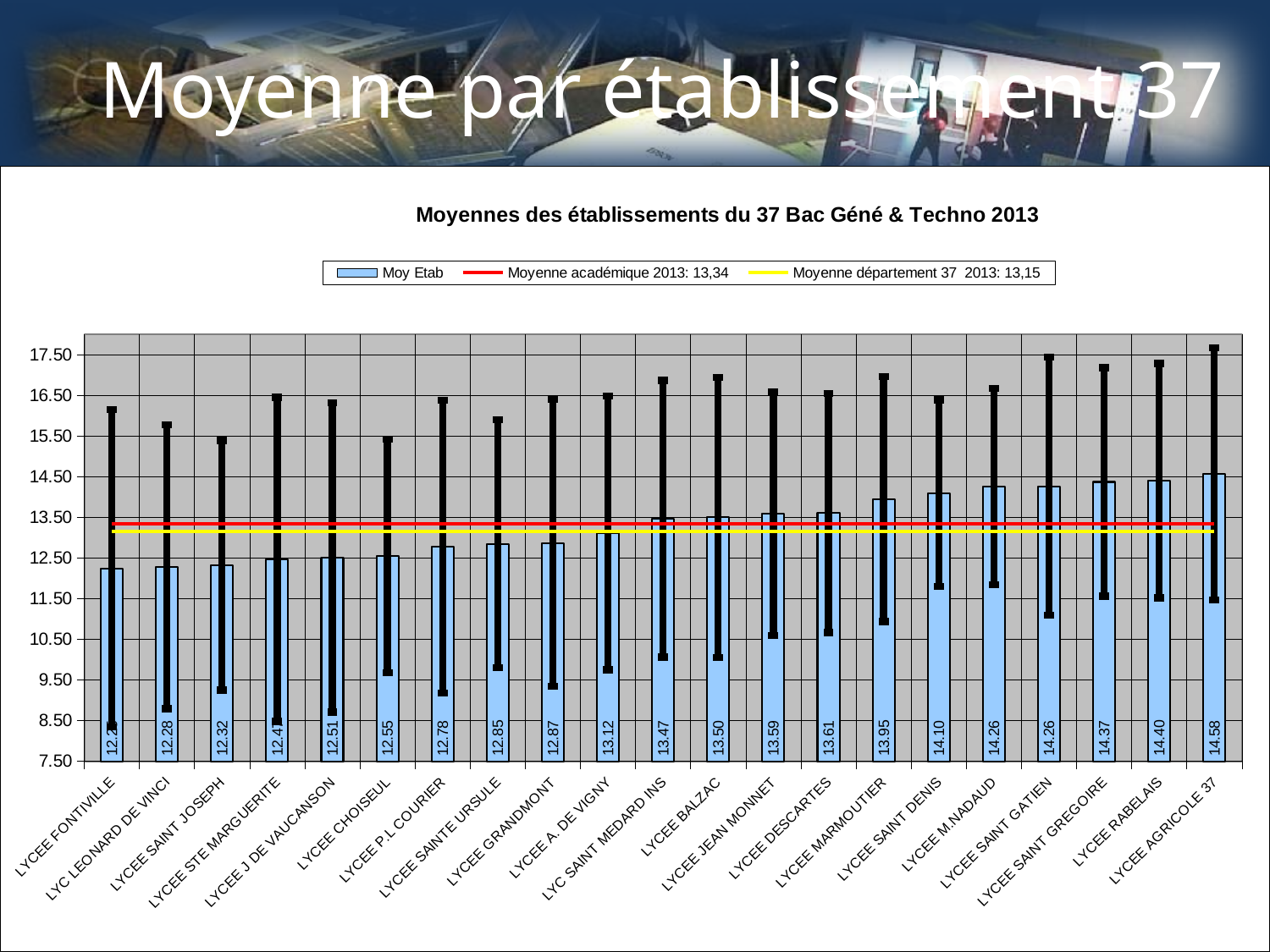
How many establishments are shown on the x axis? 21 What is the value for LYCEE MARMOUTIER? 13.95 What is the value for LYCEE BALZAC? 13.50 What is the value for LYCEE GRANDMONT? 12.87 What is the value for LYCEE AGRICOLE 37? 14.58 Which has a larger value, LYCEE DESCARTES or LYCEE CHOISEUL? LYCEE DESCARTES Is the value for LYCEE P L COURIER greater or less than 13.50? less How many entries does the legend list? 3 What kind of chart is this? bar chart Which establishment has the highest value? LYCEE AGRICOLE 37 What is the difference between the values for LYCEE RABELAIS and LYCEE SAINT DENIS? 0.30 According to the legend, what is the Moyenne académique 2013? 13,34